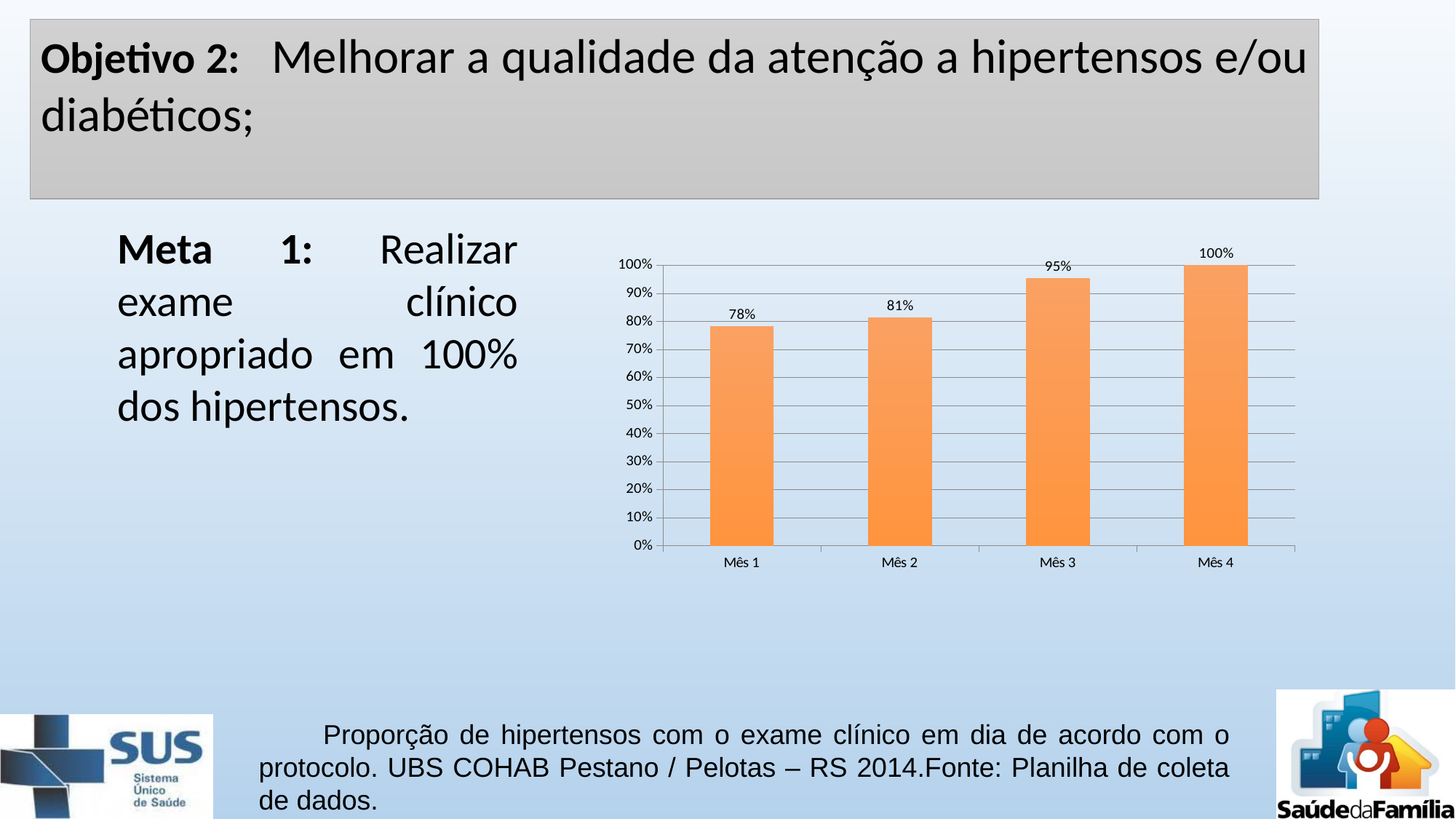
What is the value for Mês 3? 95% What is the difference between the values for Mês 4 and Mês 1? 22% Which month has the lowest value? Mês 1 Do the values rise or fall from Mês 1 to Mês 4? Rise What kind of chart is shown on the slide? Bar chart What is the value for Mês 1? 78% What is the value for Mês 2? 81% Which is larger, the value for Mês 2 or the value for Mês 3? Mês 3 Which month has the highest value? Mês 4 What is the value for Mês 4? 100% How many months are shown on the x axis? 4 What is the difference between the values for Mês 3 and Mês 2? 14%